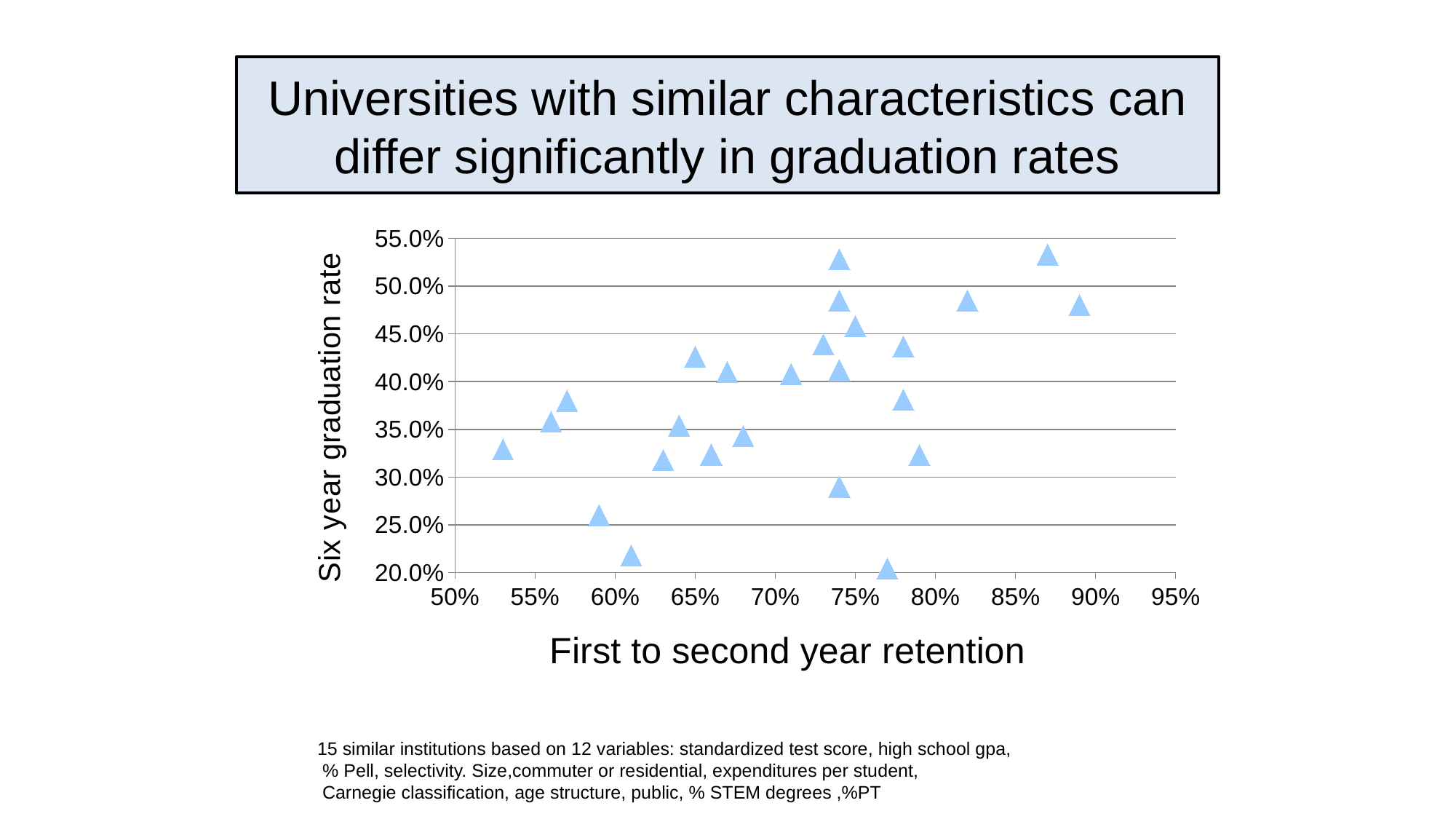
What kind of chart is shown on the slide? scatter plot Overall, do six year graduation rates tend to rise or fall as first to second year retention increases? rise What is the highest tick value shown on the vertical axis? 55.0% What is the title of the chart on the slide? Universities with similar characteristics can differ significantly in graduation rates What is the highest tick value shown on the horizontal axis? 95% Is the highest six year graduation rate plotted greater or less than 50%? greater Is the lowest six year graduation rate plotted greater or less than 25%? less Is the highest first to second year retention plotted greater or less than 85%? greater What is the label of the vertical axis? Six year graduation rate What is the lowest tick value shown on the vertical axis? 20.0%